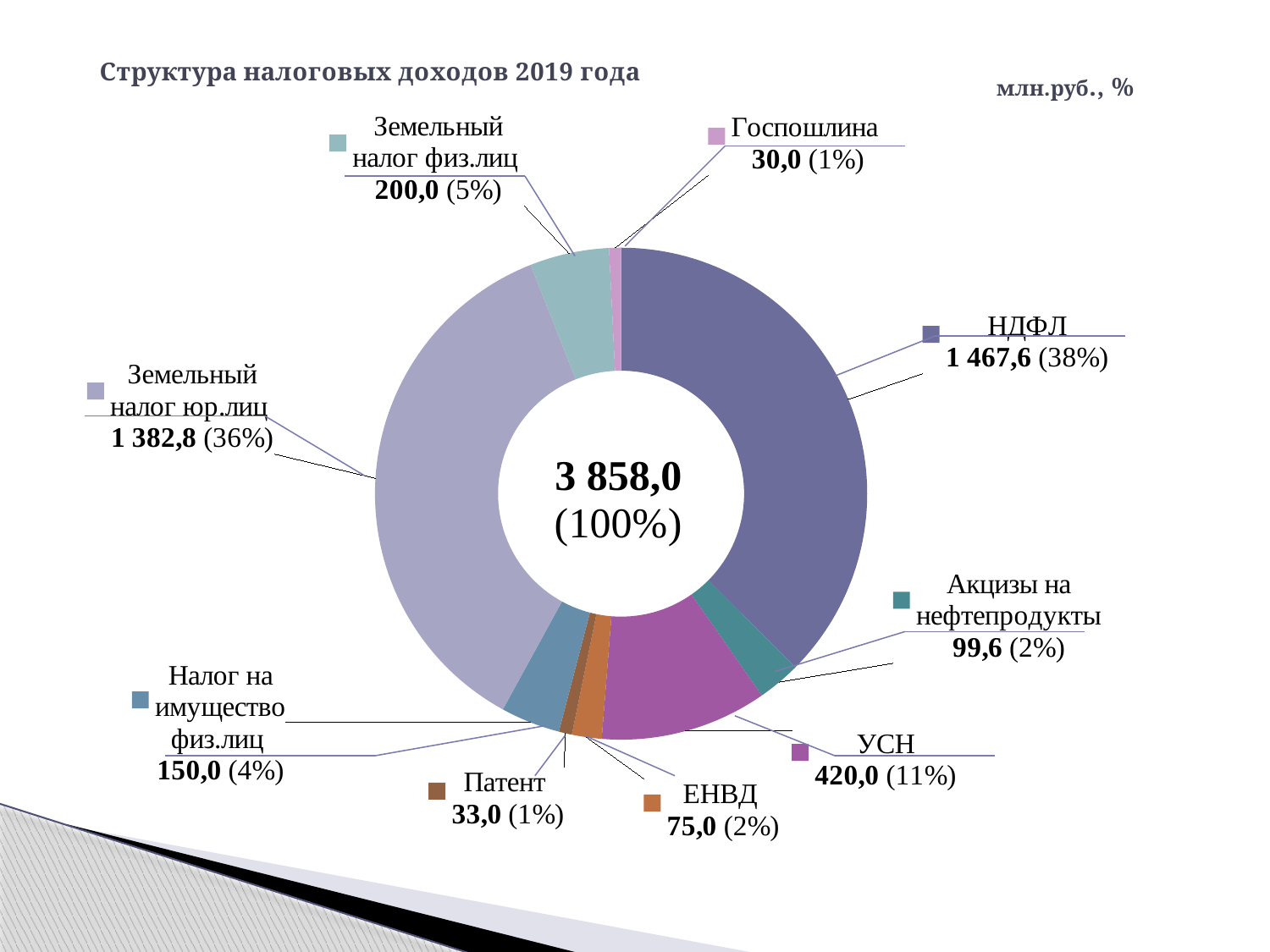
Which category has the largest value? НДФЛ What is the title of the chart? Структура налоговых доходов 2019 года What share of the total does Земельный налог юр.лиц represent? 36% What is the difference between НДФЛ and Земельный налог юр.лиц? 84,8 Which category has the smallest value? Госпошлина How many categories are shown in the chart? 9 What is the value for УСН? 420,0 What is the total value shown in the centre of the chart? 3 858,0 What is the value for Акцизы на нефтепродукты? 99,6 Which is larger, УСН or Налог на имущество физ.лиц? УСН What type of chart is shown on the slide? Doughnut (pie) chart What is the value for НДФЛ? 1 467,6